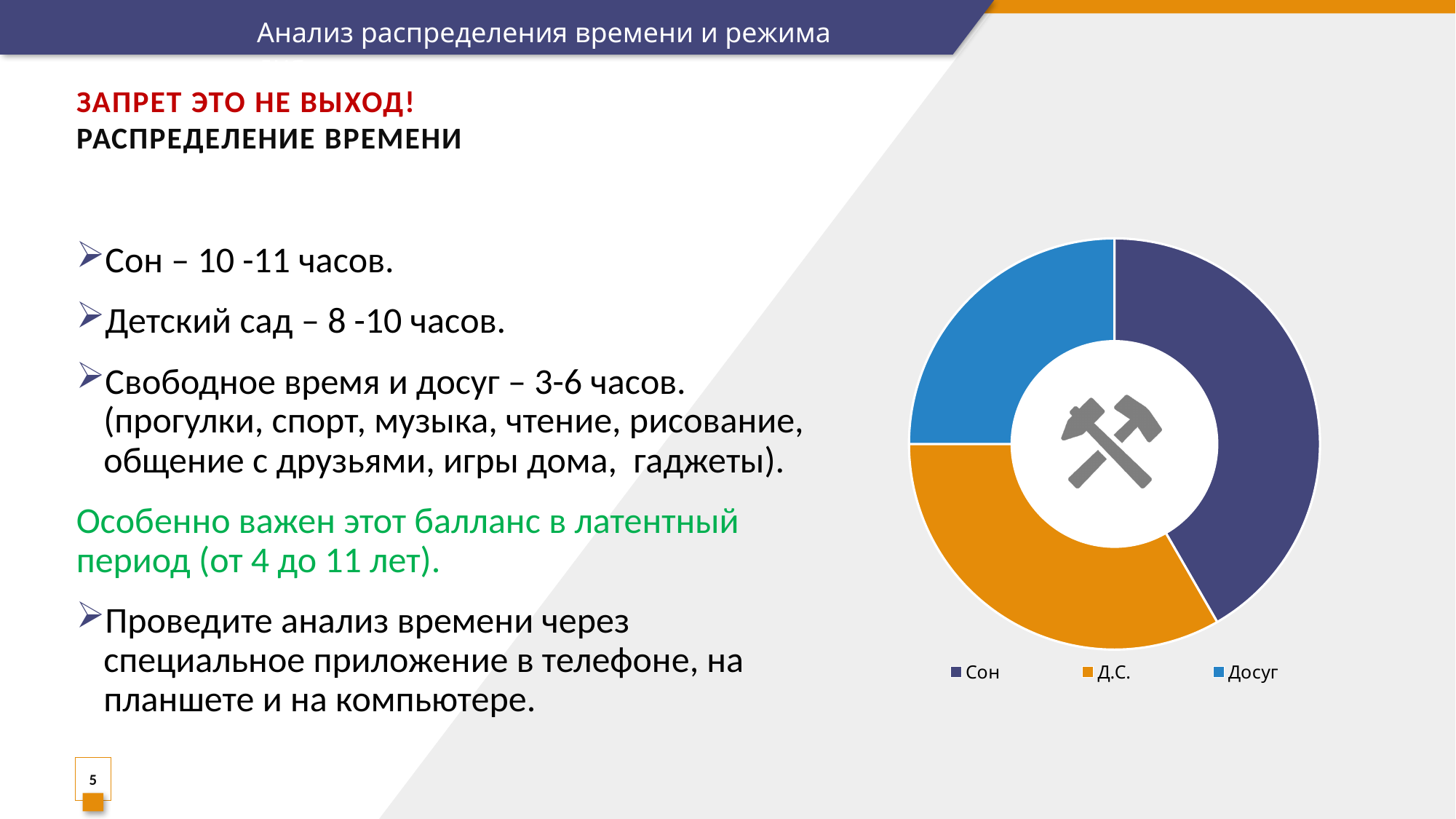
How many entries does the legend of the doughnut chart list? 3 Which category has the largest slice in the doughnut chart? Сон What colour is the Д.С. slice in the doughnut chart? Orange What kind of chart is shown on the right side of the slide? Doughnut (pie) chart How many categories does the doughnut chart show? 3 Which slice is larger in the doughnut chart, Сон or Д.С.? Сон Which category has the smallest slice in the doughnut chart? Досуг What are the three legend entries of the doughnut chart, in order? Сон, Д.С., Досуг Which slice is larger in the doughnut chart, Д.С. or Досуг? Д.С. Which slice is larger in the doughnut chart, Сон or Досуг? Сон